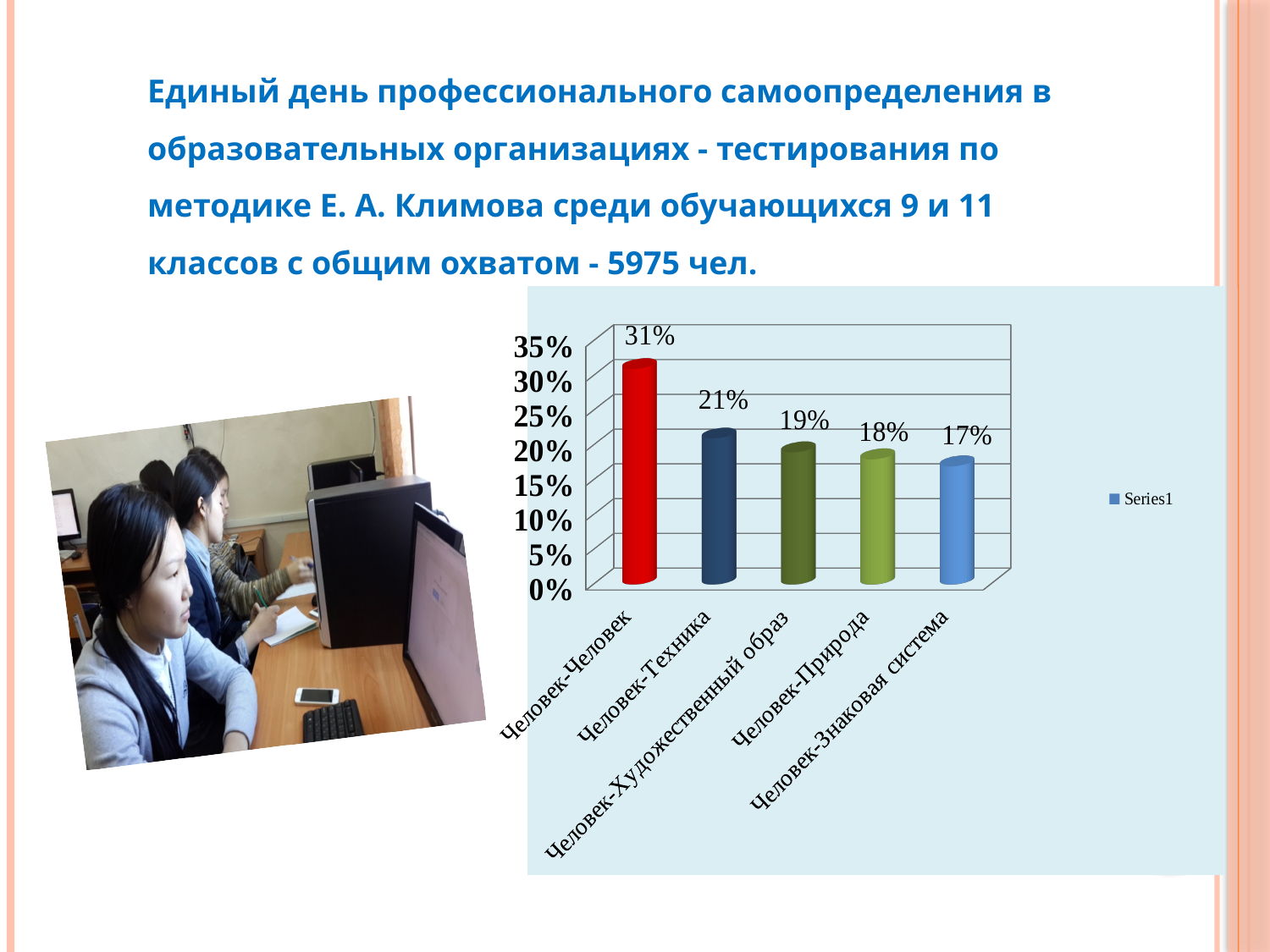
Which is larger, the value for Человек-Художественный образ or Человек-Природа? Человек-Художественный образ Which category has the highest value? Человек-Человек What kind of chart is shown? bar chart What is the difference between the values for Человек-Человек and Человек-Техника? 10% What is the value for Человек-Техника? 21% How many series does the legend list? 1 How many categories are shown on the x axis? 5 What is the value for Человек-Человек? 31% What is the name of the series in the legend? Series1 Which category has the lowest value? Человек-Знаковая система What is the value for Человек-Знаковая система? 17% Is the value for Человек-Природа greater or less than 20%? less